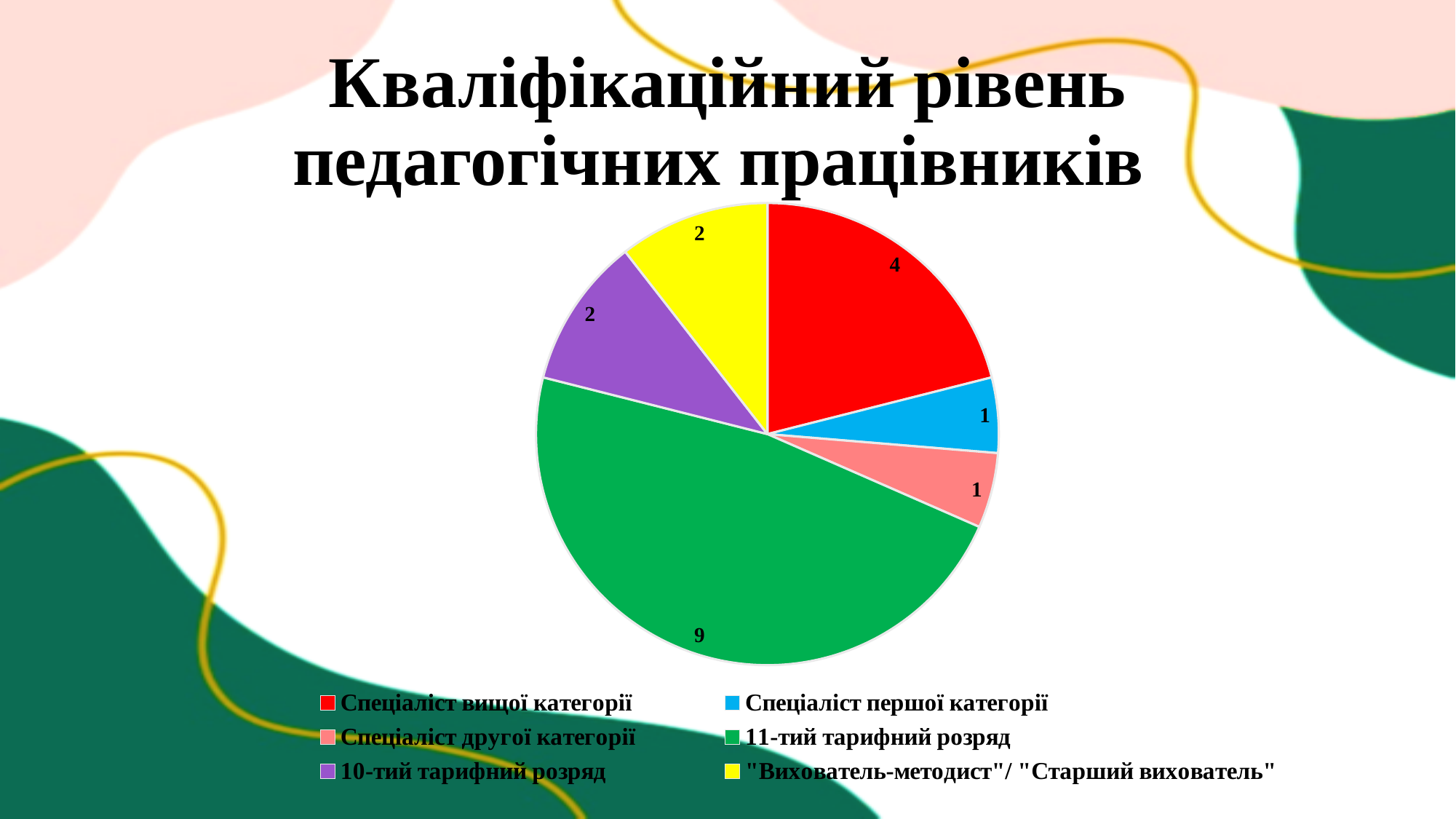
How many slices does the pie chart have? 6 What is the difference between the values for "11-тий тарифний розряд" and "Спеціаліст вищої категорії"? 5 What kind of chart is shown on the slide? Pie chart Which categories have the smallest value in the pie chart? Спеціаліст першої категорії and Спеціаліст другої категорії What is the value for "11-тий тарифний розряд"? 9 What is the value for "Спеціаліст першої категорії"? 1 What is the title of the chart on the slide? Кваліфікаційний рівень педагогічних працівників Which category has the largest slice of the pie? 11-тий тарифний розряд What is the value for "10-тий тарифний розряд"? 2 Which is larger: the value for "Спеціаліст вищої категорії" or the value for "Вихователь-методист"/"Старший вихователь"? Спеціаліст вищої категорії How many entries does the legend list? 6 What is the value for "Спеціаліст вищої категорії"? 4